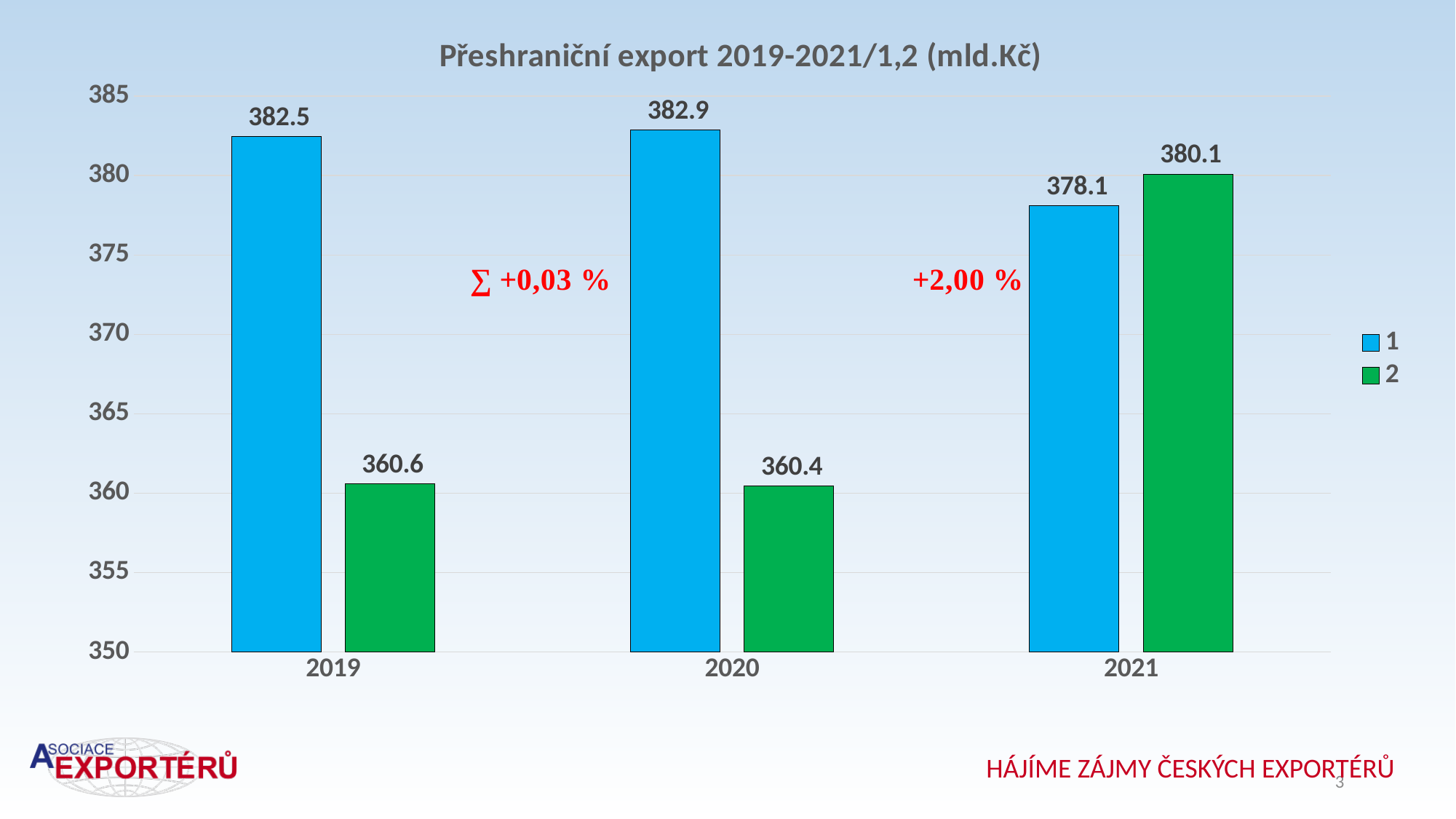
What is the value of series 1 for 2019? 382.5 What is the value of series 2 for 2021? 380.1 Does series 2 rise or fall from 2020 to 2021? rise Which is larger in 2021, series 1 or series 2? series 2 Which year has the lowest value for series 2? 2020 What is the value of series 2 for 2020? 360.4 What is the difference between series 1 and series 2 in 2019? 21.9 How many years are shown on the x axis? 3 What kind of chart is shown? bar chart What is the title of the chart? Přeshraniční export 2019-2021/1,2 (mld.Kč) How many series does the legend list? 2 Which year has the highest value for series 1? 2020